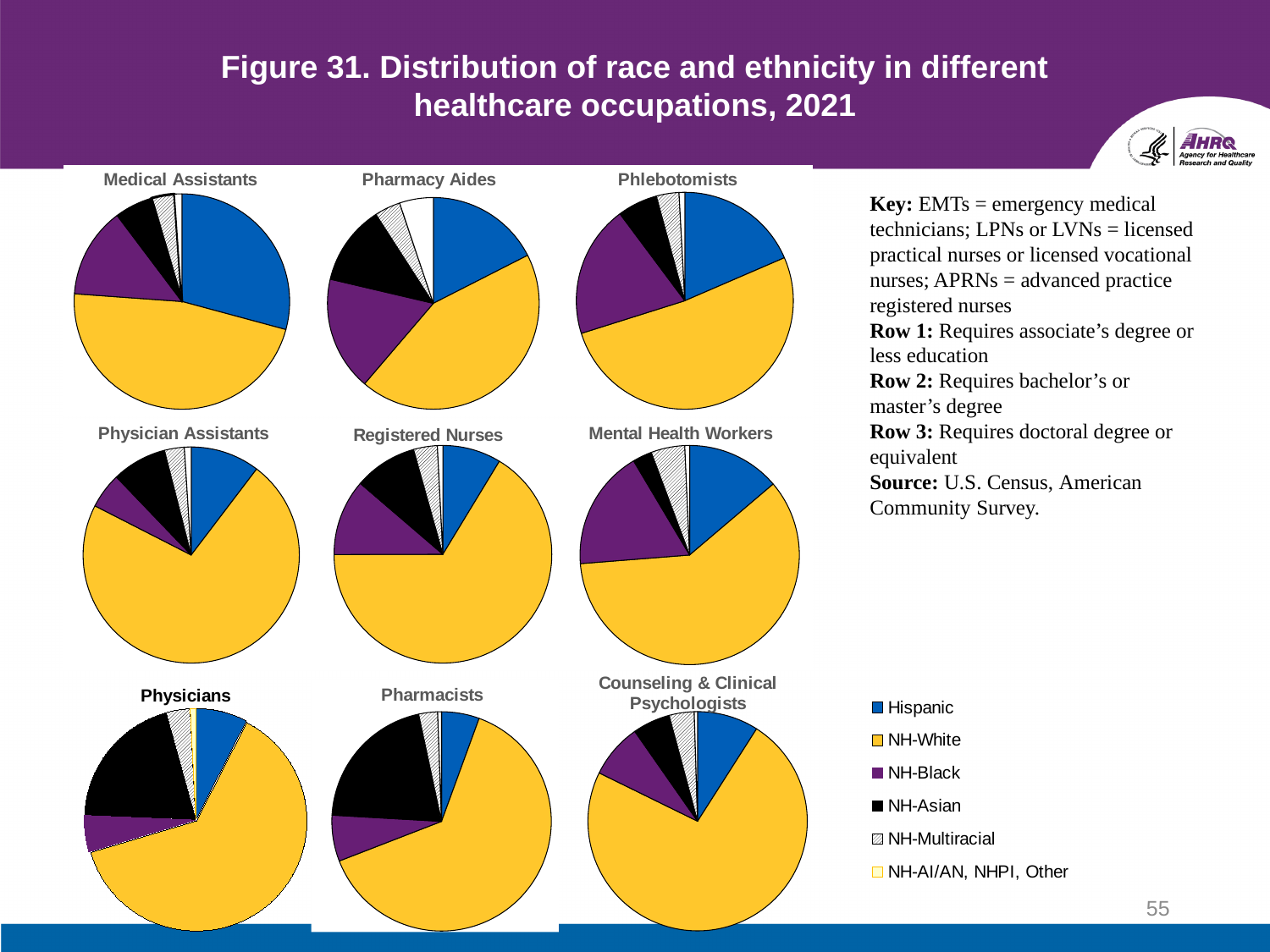
In the Physicians pie chart, which slice is larger: Hispanic or NH-Asian? NH-Asian In the Pharmacy Aides pie chart, which slice is larger: NH-White or Hispanic? NH-White In the Medical Assistants pie chart, which category has the largest slice? NH-White In the Medical Assistants pie chart, which slice is larger: Hispanic or NH-Black? Hispanic What kind of chart is used for each occupation on this slide? Pie chart How many pie charts are shown on the slide? 9 According to the legend, which colour represents NH-White? Yellow What is the title of the pie chart in the bottom-right position of the grid? Counseling & Clinical Psychologists In the Counseling & Clinical Psychologists pie chart, which category has the largest slice? NH-White How many race/ethnicity categories does the legend list? 6 In the Physicians pie chart, which category has the largest slice? NH-White